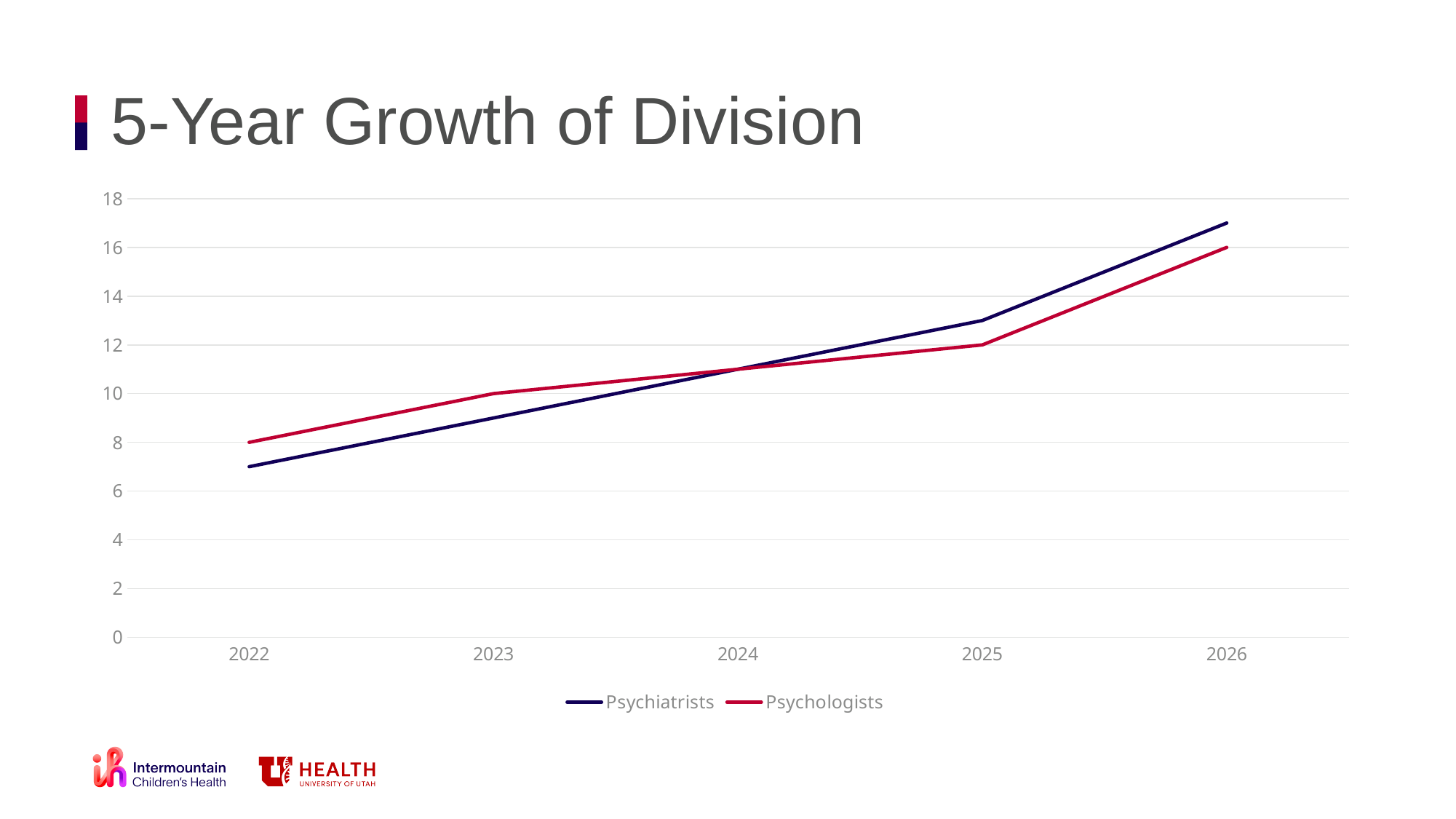
Which series has the higher value in 2022, Psychiatrists or Psychologists? Psychologists By how much does the Psychologists value increase from 2022 to 2026? 8 Which series has the higher value in 2026, Psychiatrists or Psychologists? Psychiatrists Do the Psychiatrists values rise or fall from 2022 to 2026? rise Is the value for Psychiatrists in 2026 greater or less than 16? greater How many series does the legend list? 2 Is the value for Psychiatrists in 2022 greater or less than 8? less What is the value for Psychologists in 2026? 16 What kind of chart is shown on the slide? line chart What is the value for Psychologists in 2022? 8 What is the value for Psychologists in 2025? 12 How many years are plotted along the x axis? 5